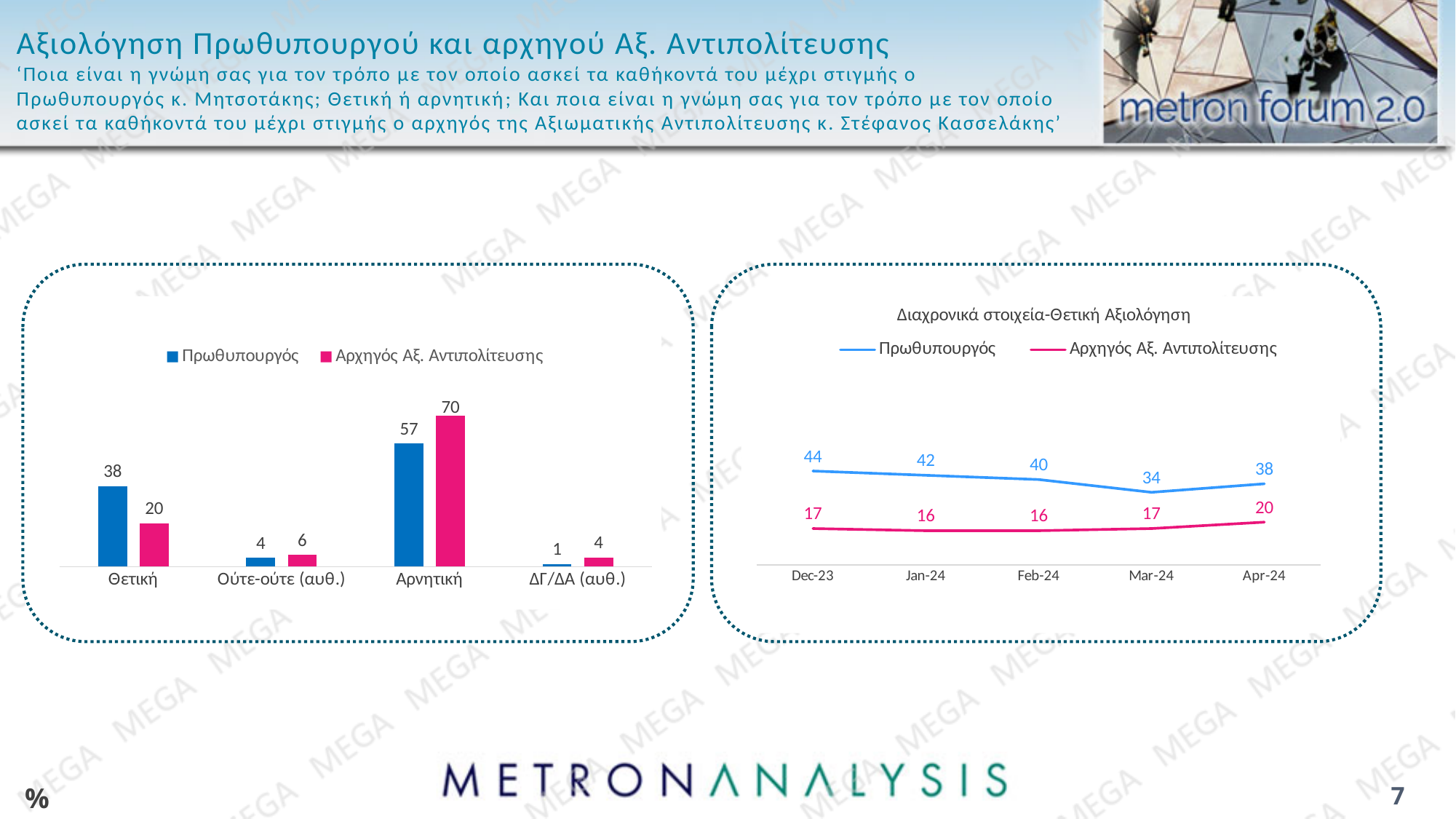
In the bar chart on the left, which category has the highest value for Πρωθυπουργός? Αρνητική In the bar chart on the left, what is the value for Πρωθυπουργός in the Θετική category? 38 In the chart titled 'Διαχρονικά στοιχεία-Θετική Αξιολόγηση', what is the value for Πρωθυπουργός in Mar-24? 34 In the bar chart on the left, which is larger in the Θετική category: Πρωθυπουργός or Αρχηγός Αξ. Αντιπολίτευσης? Πρωθυπουργός In the chart titled 'Διαχρονικά στοιχεία-Θετική Αξιολόγηση', does the Πρωθυπουργός line rise or fall from Dec-23 to Mar-24? fall What type of chart is the chart titled 'Διαχρονικά στοιχεία-Θετική Αξιολόγηση'? line chart In the bar chart on the left, what is the difference between the Αρνητική values for Αρχηγός Αξ. Αντιπολίτευσης and Πρωθυπουργός? 13 In the bar chart on the left, which category has the lowest value for Αρχηγός Αξ. Αντιπολίτευσης? ΔΓ/ΔΑ (αυθ.) In the chart titled 'Διαχρονικά στοιχεία-Θετική Αξιολόγηση', what is the value for Αρχηγός Αξ. Αντιπολίτευσης in Apr-24? 20 How many categories are shown on the x axis of the bar chart on the left? 4 How many series does the legend of the chart titled 'Διαχρονικά στοιχεία-Θετική Αξιολόγηση' list? 2 In the bar chart on the left, what is the value for Αρχηγός Αξ. Αντιπολίτευσης in the Αρνητική category? 70